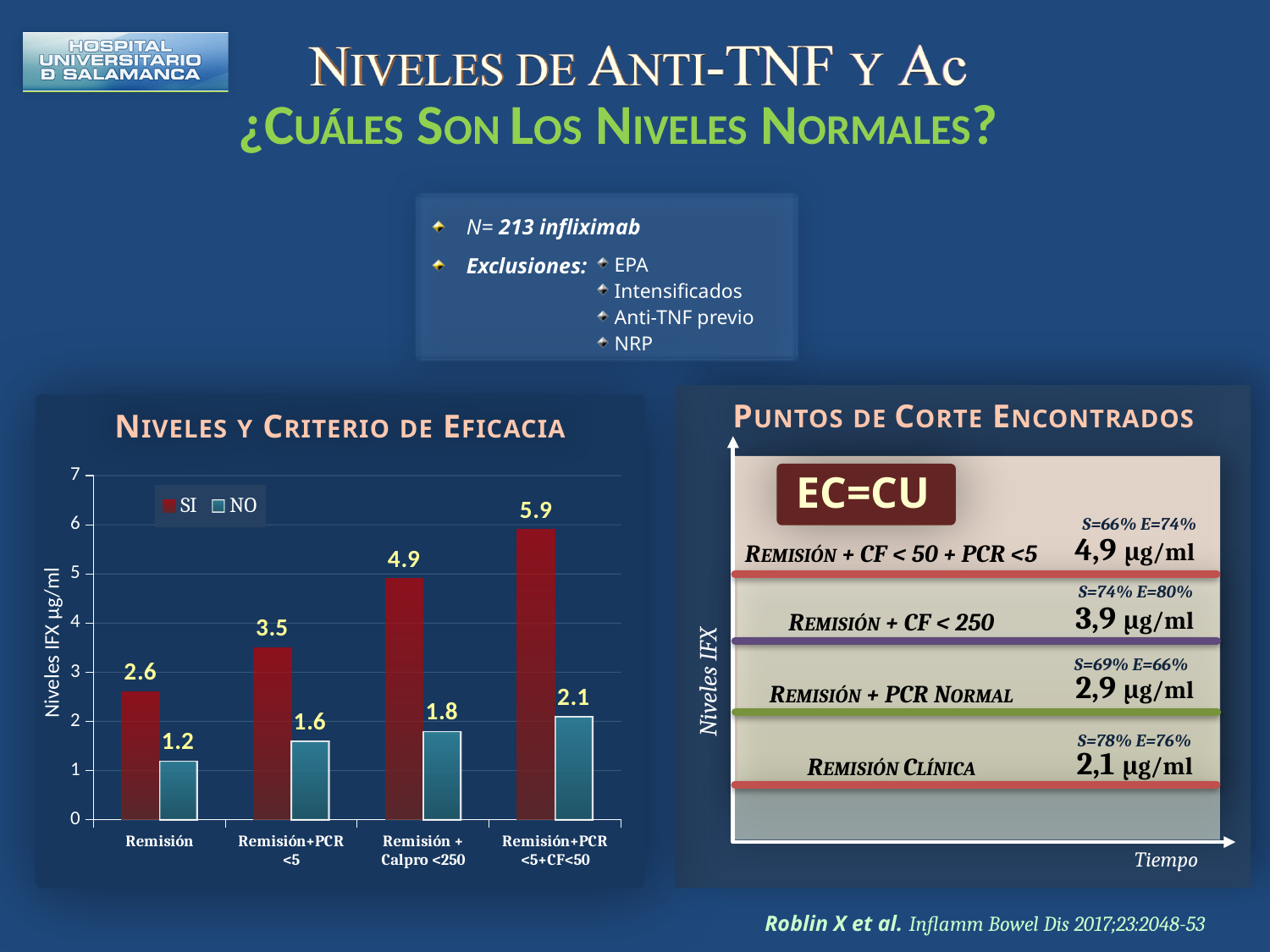
Which is larger: the SI value for Remisión + Calpro <250 or the SI value for Remisión+PCR <5? Remisión + Calpro <250 Which category has the highest SI value? Remisión+PCR <5+CF<50 How many series does the legend of the bar chart list? 2 What is the SI value for Remisión+PCR <5+CF<50? 5.9 What is the SI value for Remisión in the Niveles y Criterio de Eficacia chart? 2.6 Do the SI values rise or fall from left to right across the categories? rise What is the NO value for Remisión + Calpro <250? 1.8 What kind of chart is Niveles y Criterio de Eficacia? bar chart What is the difference between the SI and NO values for Remisión+PCR <5? 1.9 Which category has the lowest NO value? Remisión Is the SI value for Remisión + Calpro <250 greater or less than 4? greater How many categories are shown on the x axis of the bar chart? 4